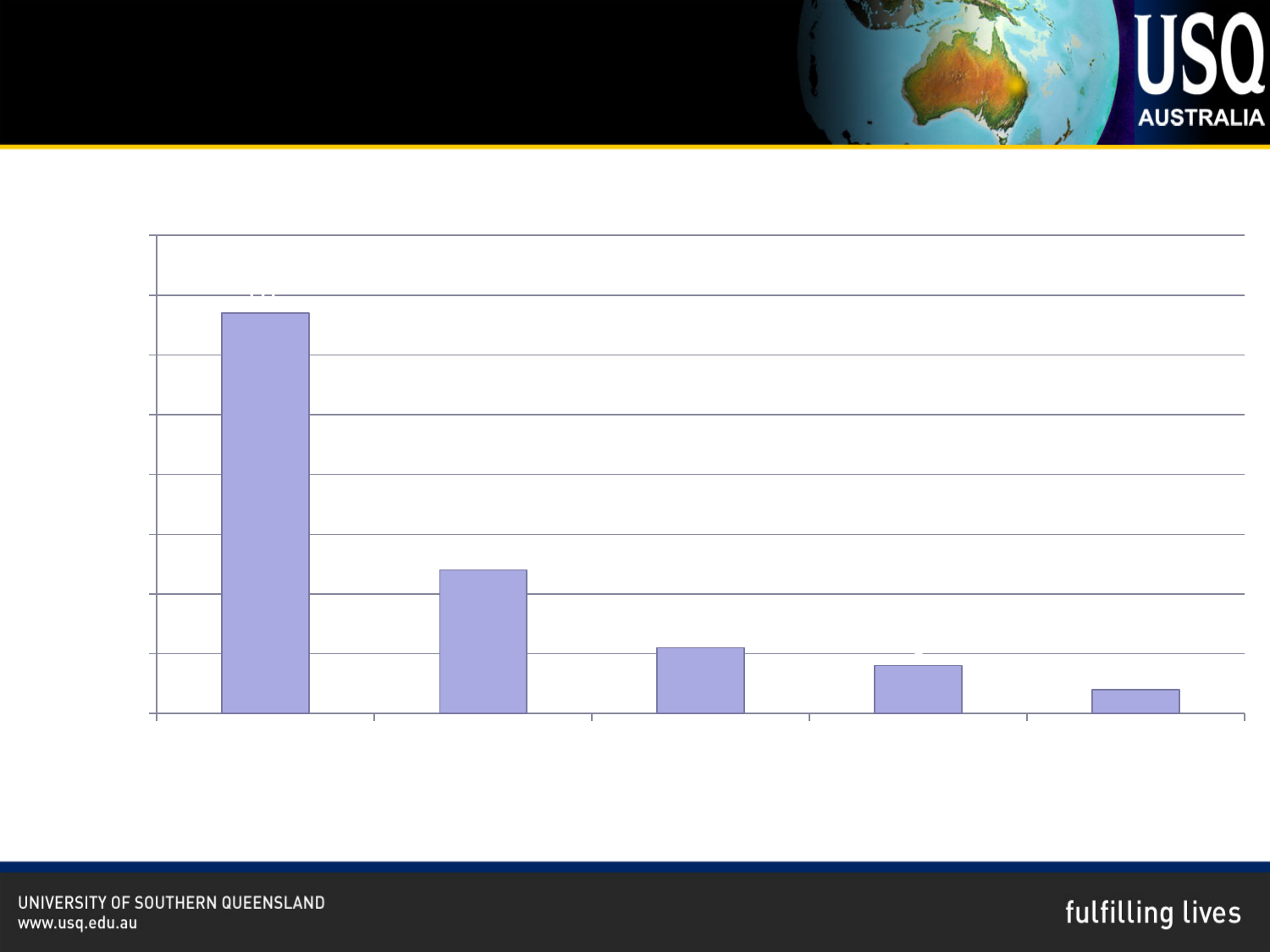
Are the bars in the chart vertical or horizontal? vertical What kind of chart is shown on the slide? bar chart Which is taller, the fourth bar or the fifth bar? the fourth bar Which bar is the shortest in the chart? the fifth (rightmost) bar What colour are the bars in the chart? light purple (lavender) Do the bar values rise or fall from left to right across the chart? fall How many bars does the chart show? 5 Which bar is the tallest in the chart? the first (leftmost) bar Which is taller, the first bar or the second bar? the first bar Which is taller, the second bar or the third bar? the second bar